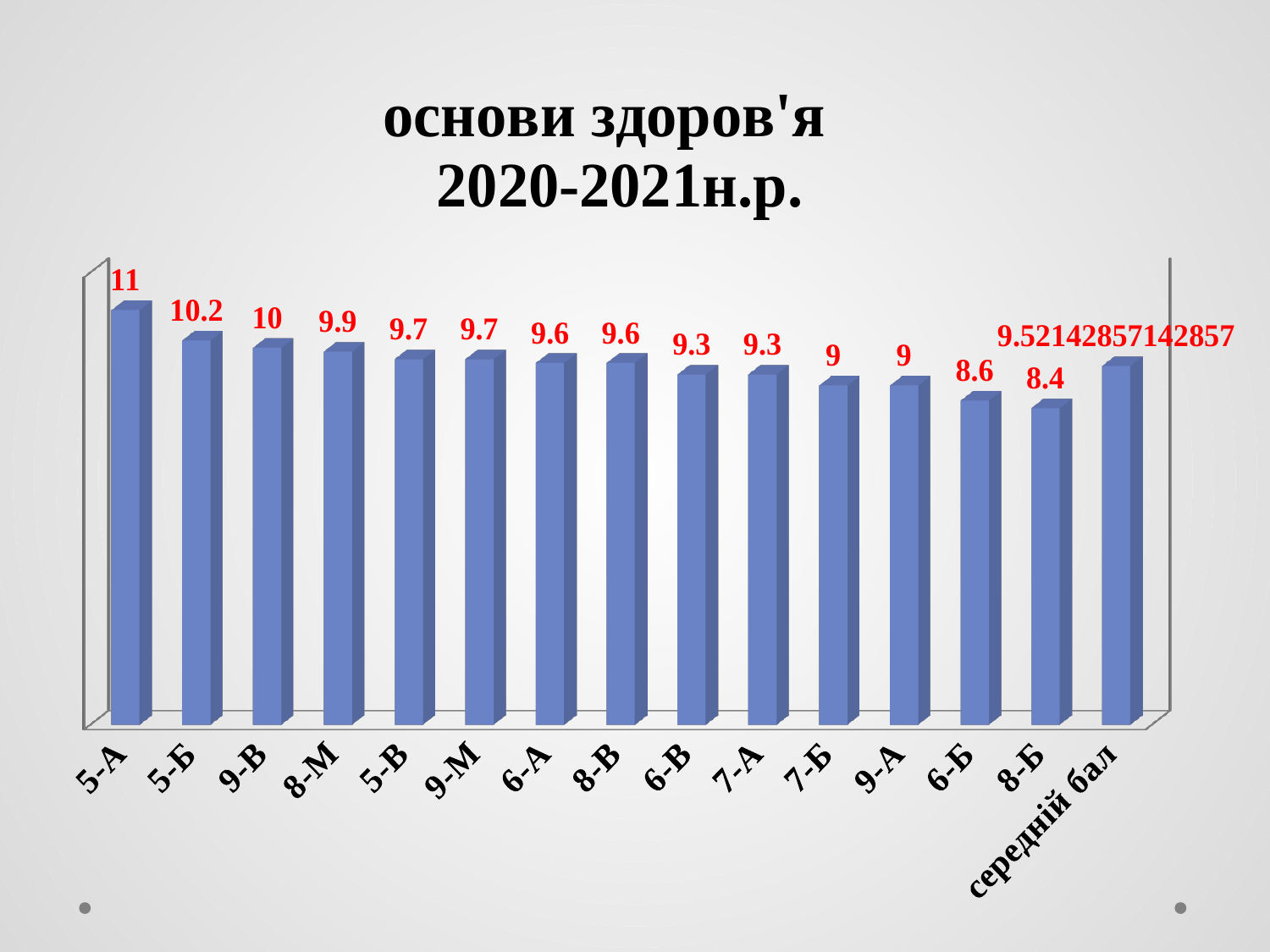
Which is larger, the value for 6-В or the value for 6-Б? 6-В What is the value for 6-Б? 8.6 What is the difference between the values for 5-А and 8-Б? 2.6 What is the value for 5-А? 11 Which category has the lowest value? 8-Б What is the difference between the values for 5-Б and 9-В? 0.2 What is the value shown for середній бал? 9.52142857142857 How many bars are shown in the chart? 15 What is the title of the chart? основи здоров'я 2020-2021н.р. Which class has the highest value? 5-А What is the value for 8-М? 9.9 What kind of chart is shown on the slide? Bar chart